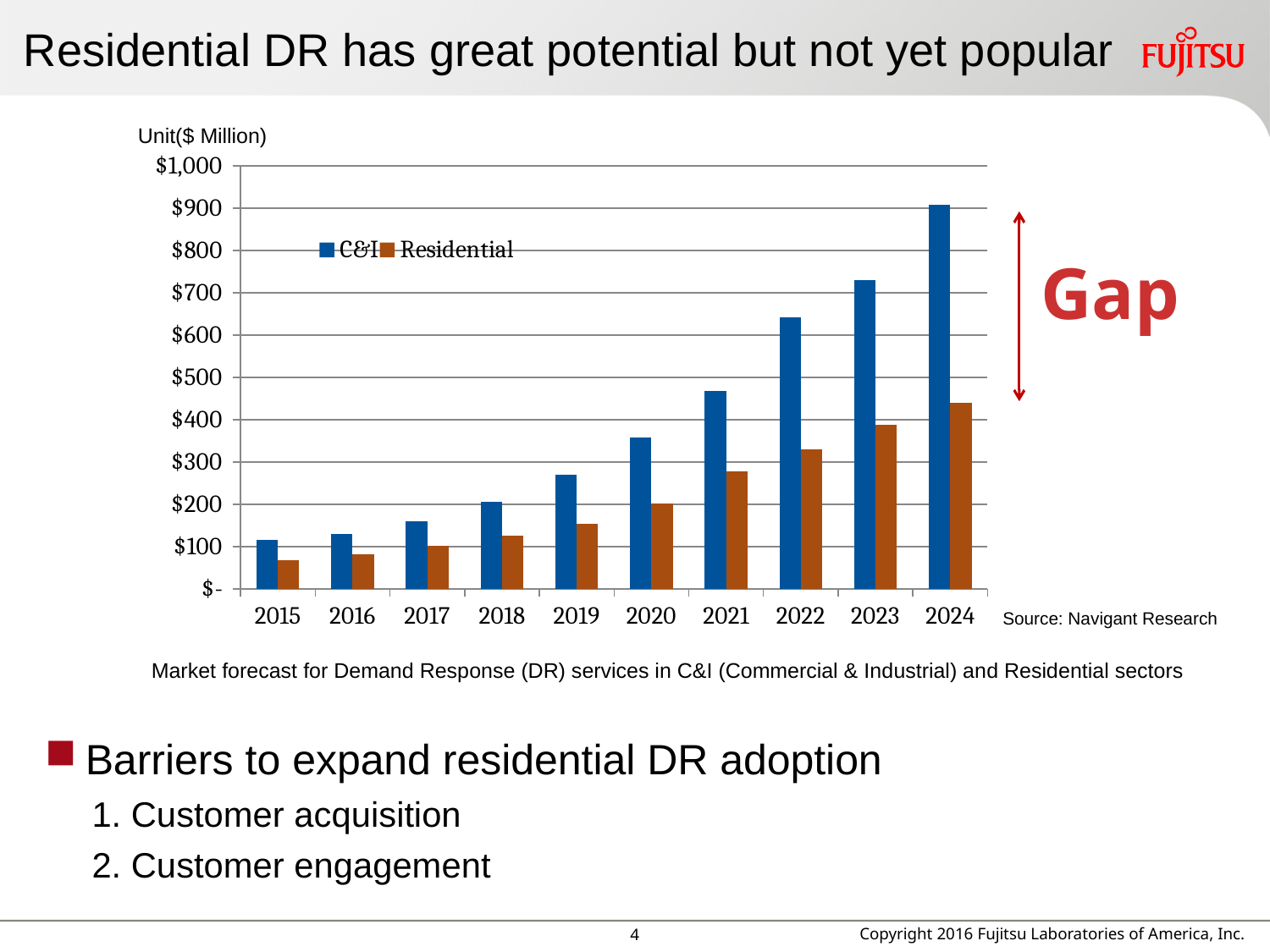
Which year has the highest C&I value? 2024 Which year has the lowest Residential value? 2015 In 2023, which series has the larger value, C&I or Residential? C&I How many years are shown on the x axis of the chart? 10 Is the Residential value for 2024 greater or less than $500? less How many series does the chart legend list? 2 Is the C&I value for 2022 greater or less than $600? greater Do the Residential values rise or fall from 2015 to 2024? rise What kind of chart is shown on the slide? bar chart Is the C&I value for 2015 greater or less than $200? less What unit is stated for the values on the chart? $ Million